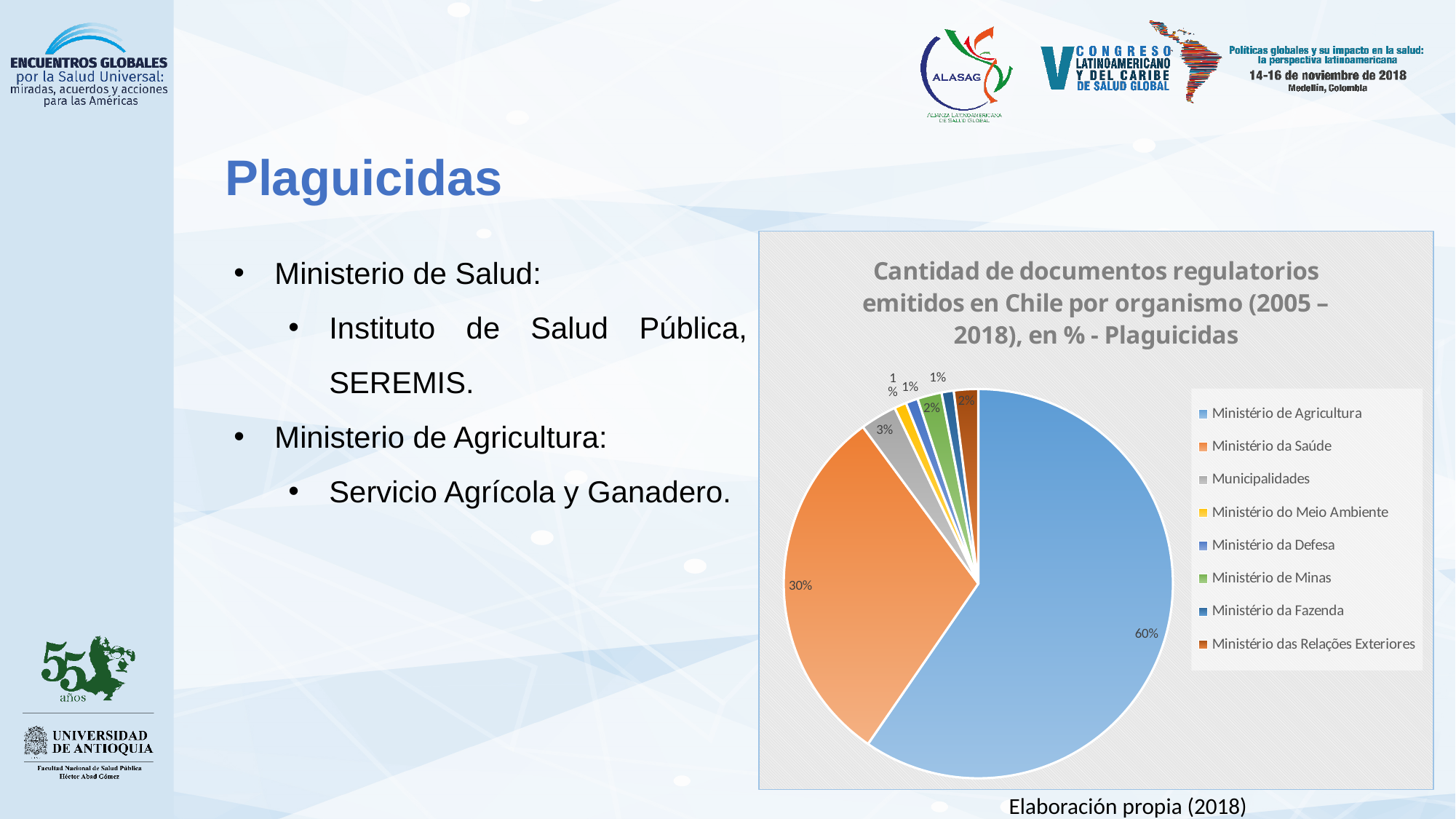
What is the value shown for Ministério da Fazenda? 1% Which is larger, the slice for Ministério da Saúde or the slice for Municipalidades? Ministério da Saúde What colour is the slice for Ministério da Saúde? orange What is the value shown for Ministério de Minas? 2% What share of the pie does Ministério de Agricultura hold? 60% What share of the pie does Ministério da Saúde hold? 30% What is the title of the chart? Cantidad de documentos regulatorios emitidos en Chile por organismo (2005 – 2018), en % - Plaguicidas Which organism has the largest slice of the pie? Ministério de Agricultura What is the difference in percentage points between Ministério de Agricultura and Ministério da Saúde? 30 What type of chart is shown on the slide? pie chart What is the value shown for Municipalidades? 3% How many organisms are listed in the legend? 8